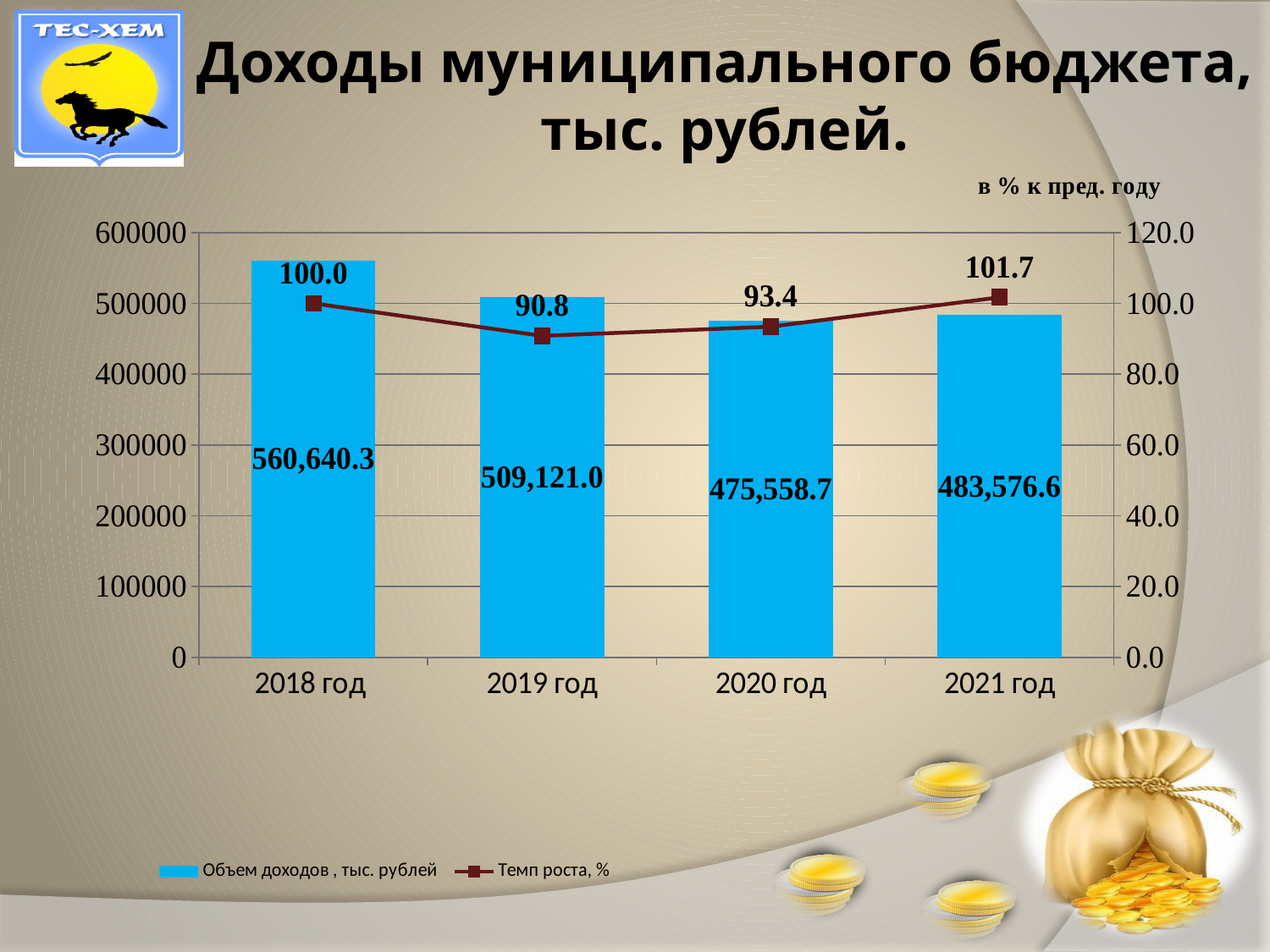
How many series does the legend list? 2 What is the title of the chart? Доходы муниципального бюджета, тыс. рублей. Which is larger, 'Объем доходов, тыс. рублей' for 2020 год or for 2021 год? 2021 год What is the difference in 'Объем доходов, тыс. рублей' between 2018 год and 2019 год? 51,519.3 Which year has the lowest 'Объем доходов, тыс. рублей'? 2020 год Which year has the highest 'Объем доходов, тыс. рублей'? 2018 год How many years are shown on the x axis? 4 Which year has the lowest 'Темп роста, %'? 2019 год What is the value of 'Объем доходов, тыс. рублей' for 2018 год? 560,640.3 What is the value of 'Темп роста, %' for 2019 год? 90.8 What is the difference in 'Темп роста, %' between 2021 год and 2020 год? 8.3 What is the value of 'Объем доходов, тыс. рублей' for 2021 год? 483,576.6